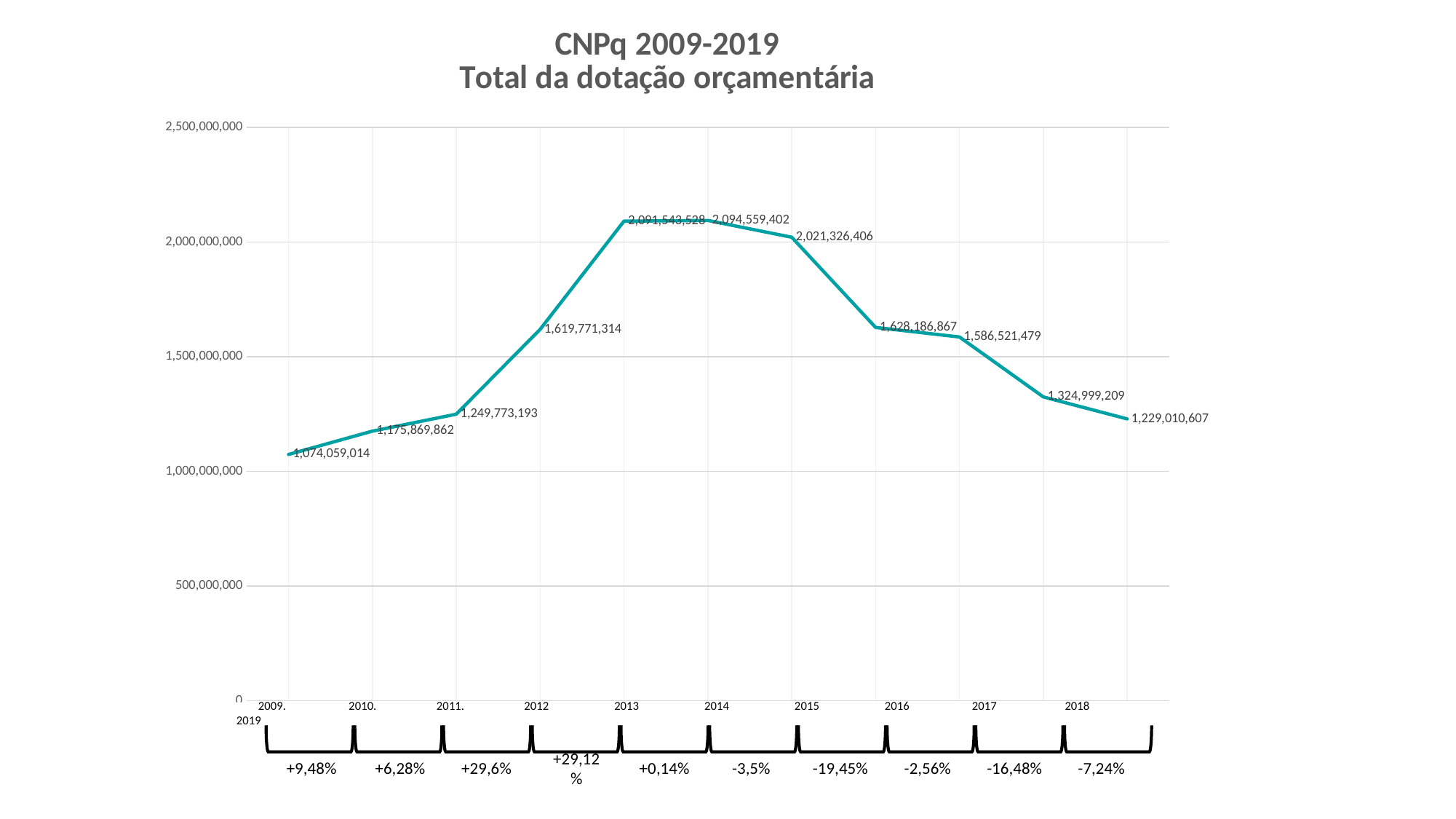
Which year has the highest value? 2014 Which is larger, the value for 2016 or the value for 2018? 2016 What is the difference between the values for 2012 and 2011? 369,998,121 What is the value plotted for 2009? 1,074,059,014 What is the title of the chart? CNPq 2009-2019 Total da dotação orçamentária What type of chart is shown on the slide? line chart What is the value plotted for 2019? 1,229,010,607 What is the value plotted for 2017? 1,586,521,479 Which year has the lowest value? 2009 What is the value plotted for 2014? 2,094,559,402 Is the value for 2015 greater or less than 2,000,000,000? greater How many data points are plotted on the line? 11